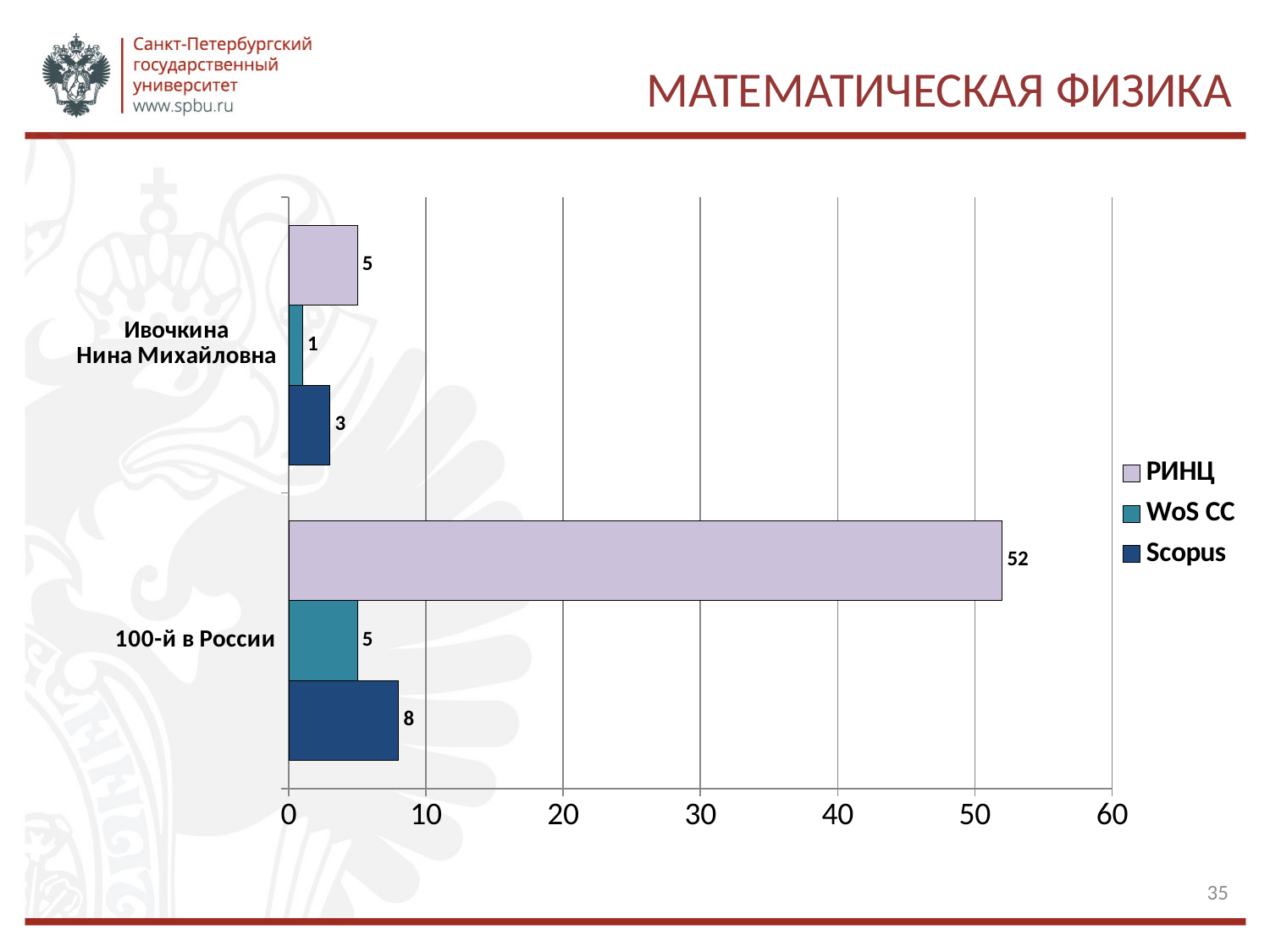
What is the Scopus value for 100-й в России? 8 What is the РИНЦ value for 100-й в России? 52 Which is larger: the Scopus value for 100-й в России or the Scopus value for Ивочкина Нина Михайловна? 100-й в России What is the Scopus value for Ивочкина Нина Михайловна? 3 What kind of chart is shown on the slide? bar chart How many categories are shown on the chart? 2 What is the WoS CC value for Ивочкина Нина Михайловна? 1 What is the difference between the РИНЦ values for 100-й в России and Ивочкина Нина Михайловна? 47 How many series does the legend list? 3 What is the РИНЦ value for Ивочкина Нина Михайловна? 5 Which series has the highest value for 100-й в России? РИНЦ Which series has the lowest value for Ивочкина Нина Михайловна? WoS CC